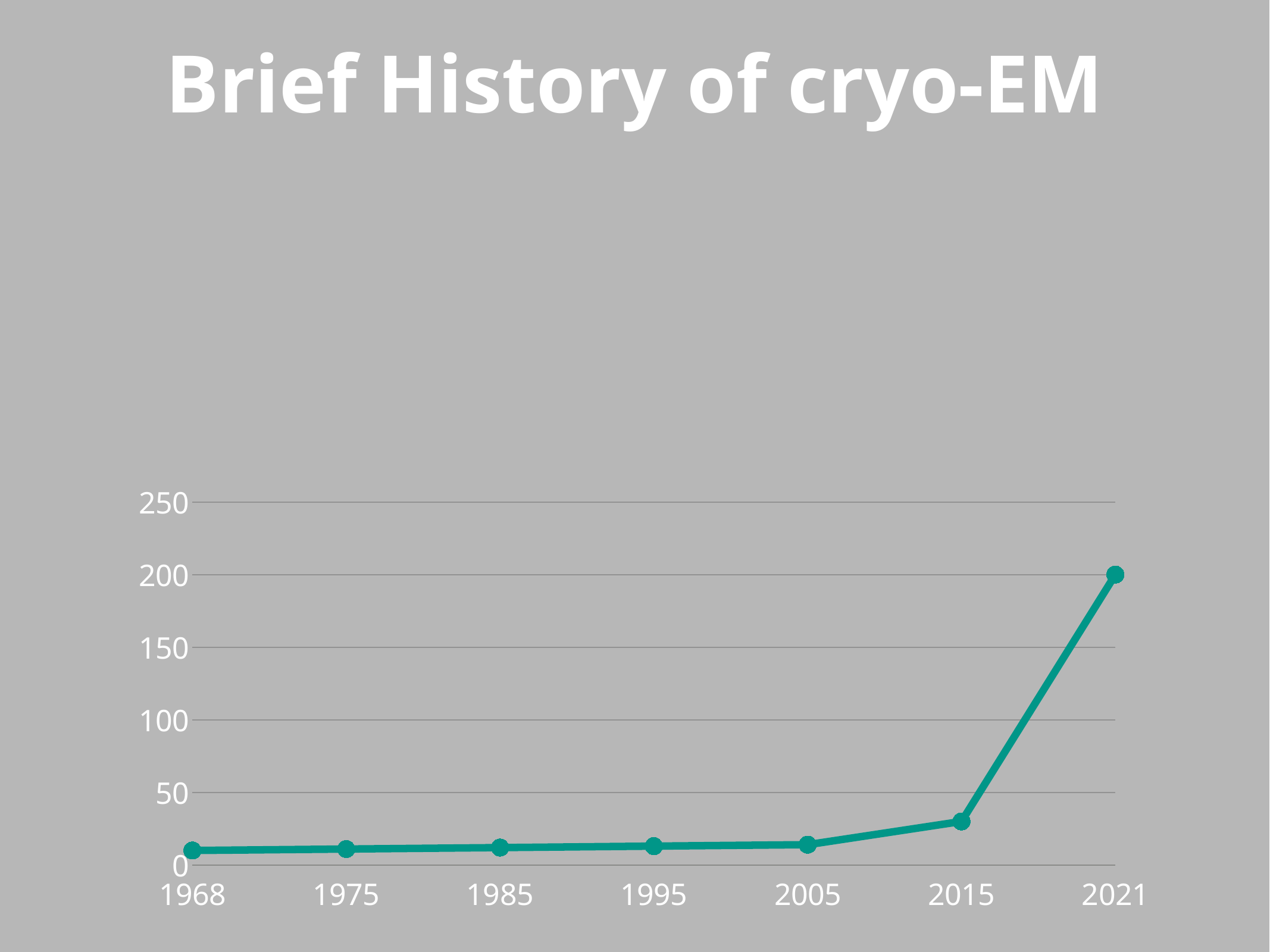
What kind of chart is shown on the slide? line chart Is the value for 1985 greater or less than 100? less What is the first year shown on the x axis of the chart? 1968 What is the title of the slide containing the chart? Brief History of cryo-EM Is the value for 2021 greater or less than 150? greater Is the value for 2015 greater or less than 50? less How many data points are plotted on the line chart? 7 Which year has the larger value, 2005 or 2015? 2015 Which year has the larger value, 2015 or 2021? 2021 Do the values rise or fall from 1968 to 2021? rise Which year has the highest value on the chart? 2021